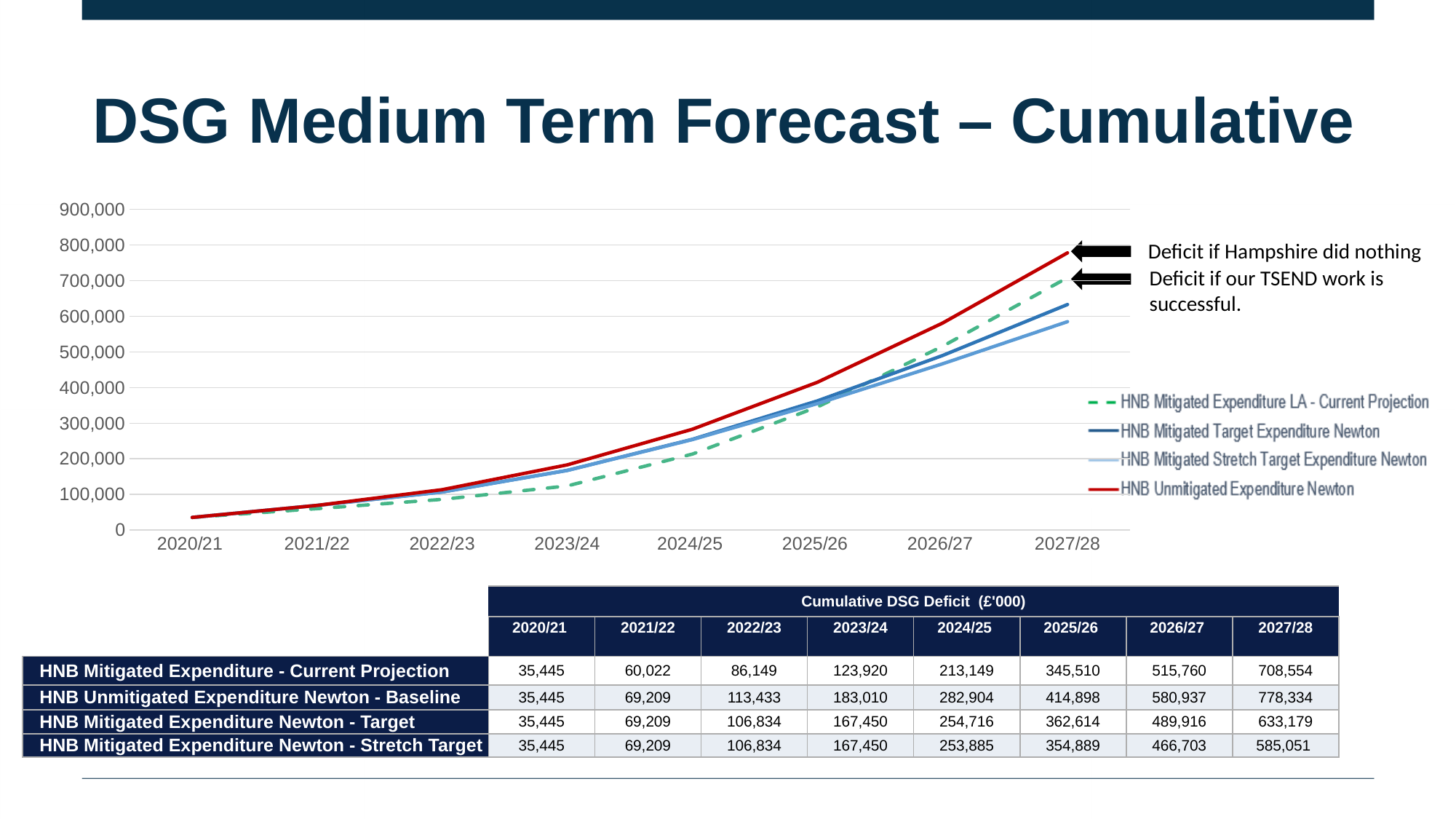
What kind of chart is shown on the slide? Line chart What is the cumulative DSG deficit (£'000) for HNB Unmitigated Expenditure Newton in 2027/28? 778,334 What is the difference between the HNB Mitigated Target and HNB Mitigated Stretch Target values in 2027/28 (£'000)? 48,128 Which series has the lowest value in 2027/28? HNB Mitigated Stretch Target Expenditure Newton Do the values of the HNB Unmitigated Expenditure Newton line rise or fall from 2020/21 to 2027/28? Rise What is the difference between the HNB Unmitigated Expenditure Newton value and the HNB Mitigated Expenditure Current Projection value in 2027/28 (£'000)? 69,780 Which series has the highest value in 2027/28? HNB Unmitigated Expenditure Newton How many financial years are plotted along the x axis of the chart? 8 In 2025/26, which is larger: HNB Unmitigated Expenditure Newton or HNB Mitigated Expenditure Current Projection? HNB Unmitigated Expenditure Newton What is the cumulative DSG deficit (£'000) for HNB Mitigated Stretch Target Expenditure Newton in 2027/28? 585,051 Is the value for HNB Unmitigated Expenditure Newton in 2027/28 greater or less than 700,000? greater How many series does the chart legend list? 4